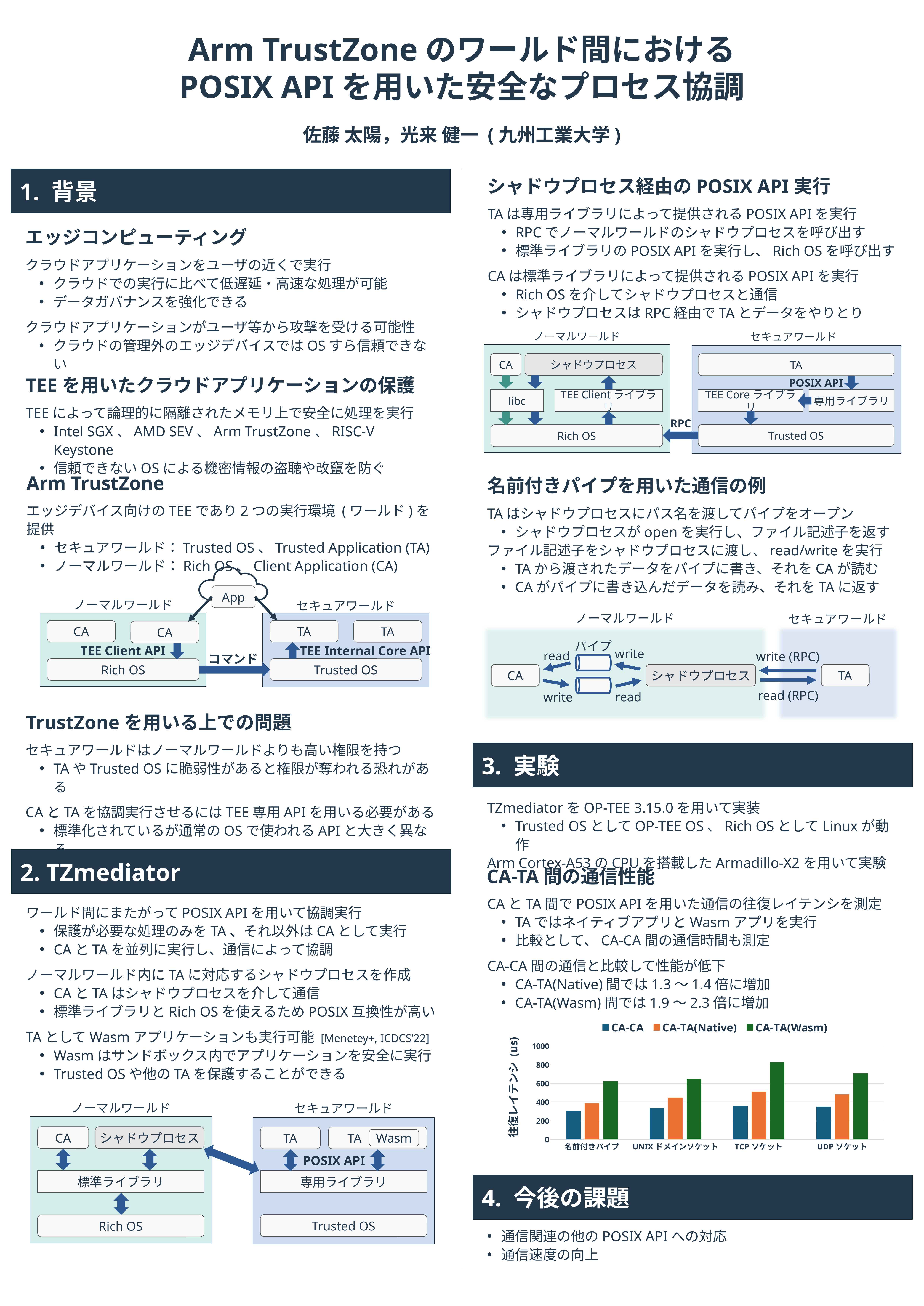
What is the label of the y axis of the bar chart? 往復レイテンシ (us) What kind of chart is shown in the 実験 section? bar chart For UNIX ドメインソケット, which series has the larger value: CA-CA or CA-TA(Wasm)? CA-TA(Wasm) Which category has the highest CA-TA(Wasm) value in the bar chart? TCP ソケット How many series does the legend of the bar chart list? 3 How many categories are shown on the x axis of the bar chart? 4 Is the CA-TA(Wasm) value for TCP ソケット greater or less than 800? greater Is the CA-TA(Wasm) value for UDP ソケット greater or less than 600? greater Is the CA-CA value for 名前付きパイプ greater or less than 400? less Which series in the bar chart is drawn in orange? CA-TA(Native) Which category has the lowest CA-TA(Wasm) value in the bar chart? 名前付きパイプ